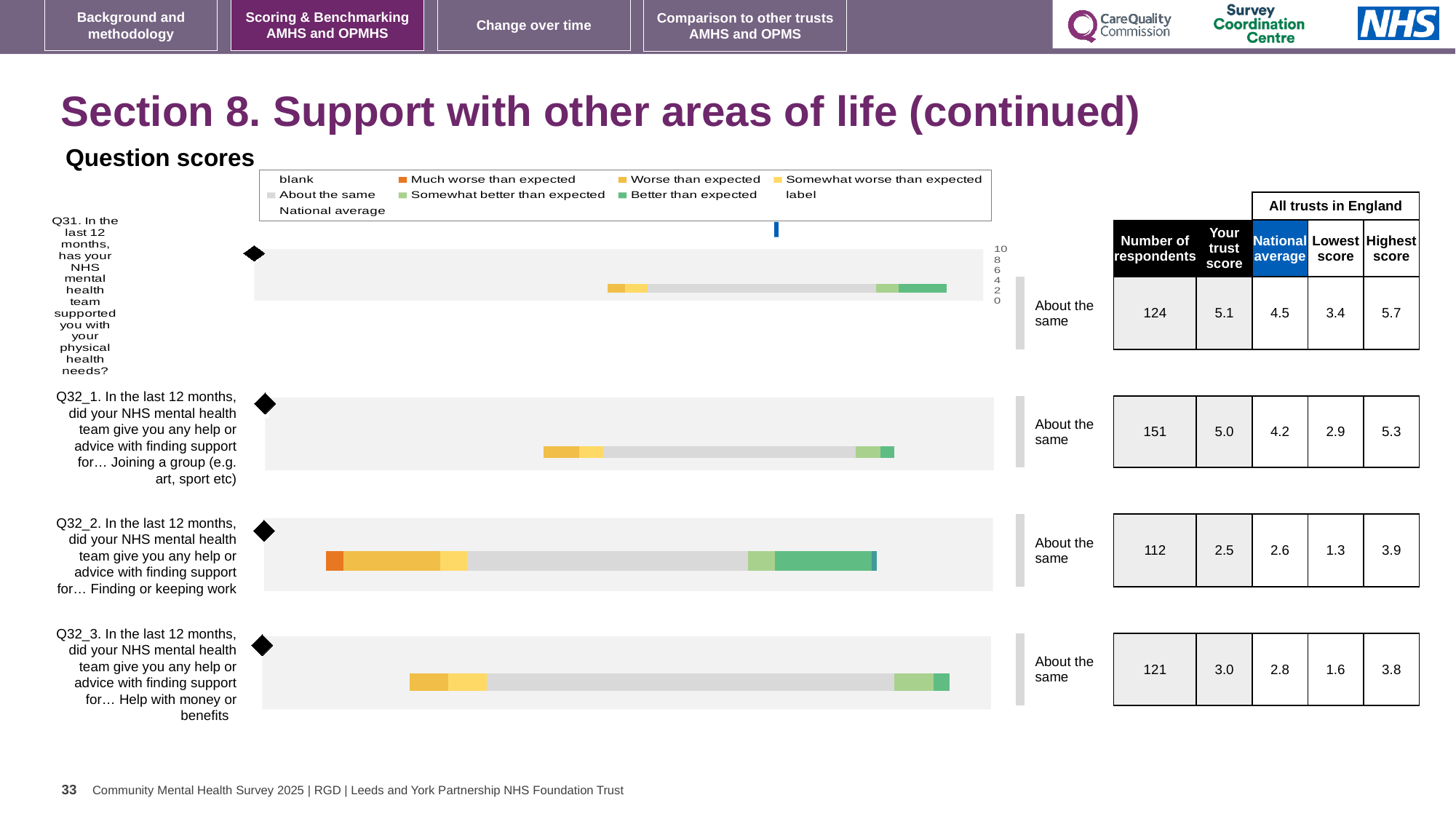
What benchmark category is shown next to each bar in the question scores chart? About the same How many questions (bars) are plotted in the question scores chart? 4 What is the 'Your trust score' value for Q32_2 (Finding or keeping work)? 2.5 What is the highest score among all trusts in England for Q32_3 (Help with money or benefits)? 3.8 What is the national average for Q32_1 (Joining a group)? 4.2 Which question has the lowest 'Your trust score'? Q32_2 (Finding or keeping work) What kind of chart is used to show the question scores on this slide? bar chart Which question has the highest number of respondents? Q32_1 (Joining a group) What is the difference between the trust score and the national average for Q31 (physical health needs)? 0.6 What is the number of respondents for Q31 (physical health needs)? 124 For Q32_3 (Help with money or benefits), which is larger: the trust score or the national average? the trust score (3.0) How many entries does the legend of the question scores chart list? 9